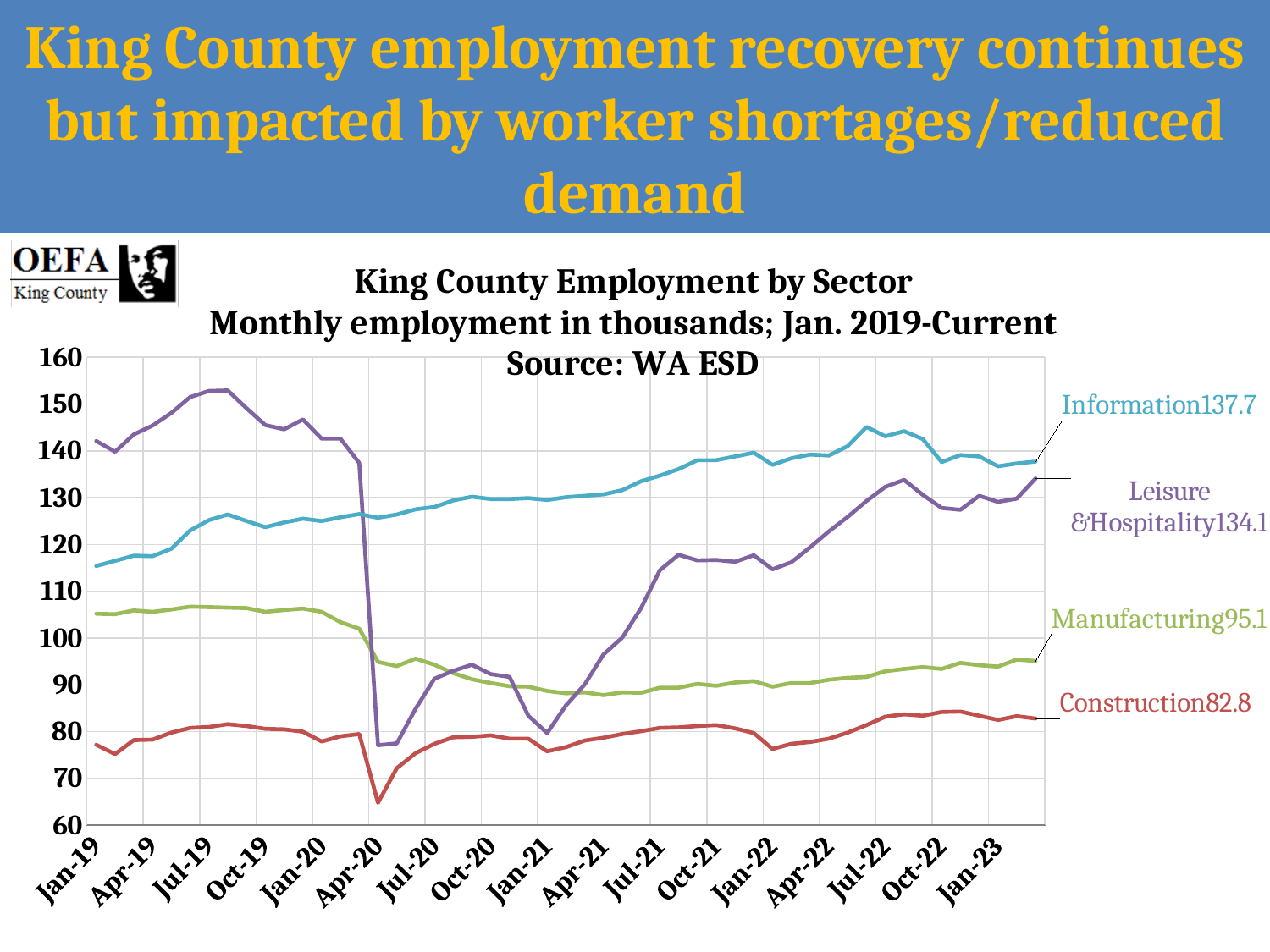
What is the latest value shown for Construction? 82.8 What kind of chart is shown? line chart Which sector has the highest latest value? Information How many sectors are plotted on the chart? 4 What is the latest value shown for Manufacturing? 95.1 Which is larger at the latest point, Manufacturing or Construction? Manufacturing Is the value for Construction in Apr-20 greater or less than 70? less What is the latest value shown for Information? 137.7 What is the source of the data given in the chart title? WA ESD Which sector has the lowest latest value? Construction What is the latest value shown for Leisure & Hospitality? 134.1 What is the difference between the latest values for Information and Leisure & Hospitality? 3.6